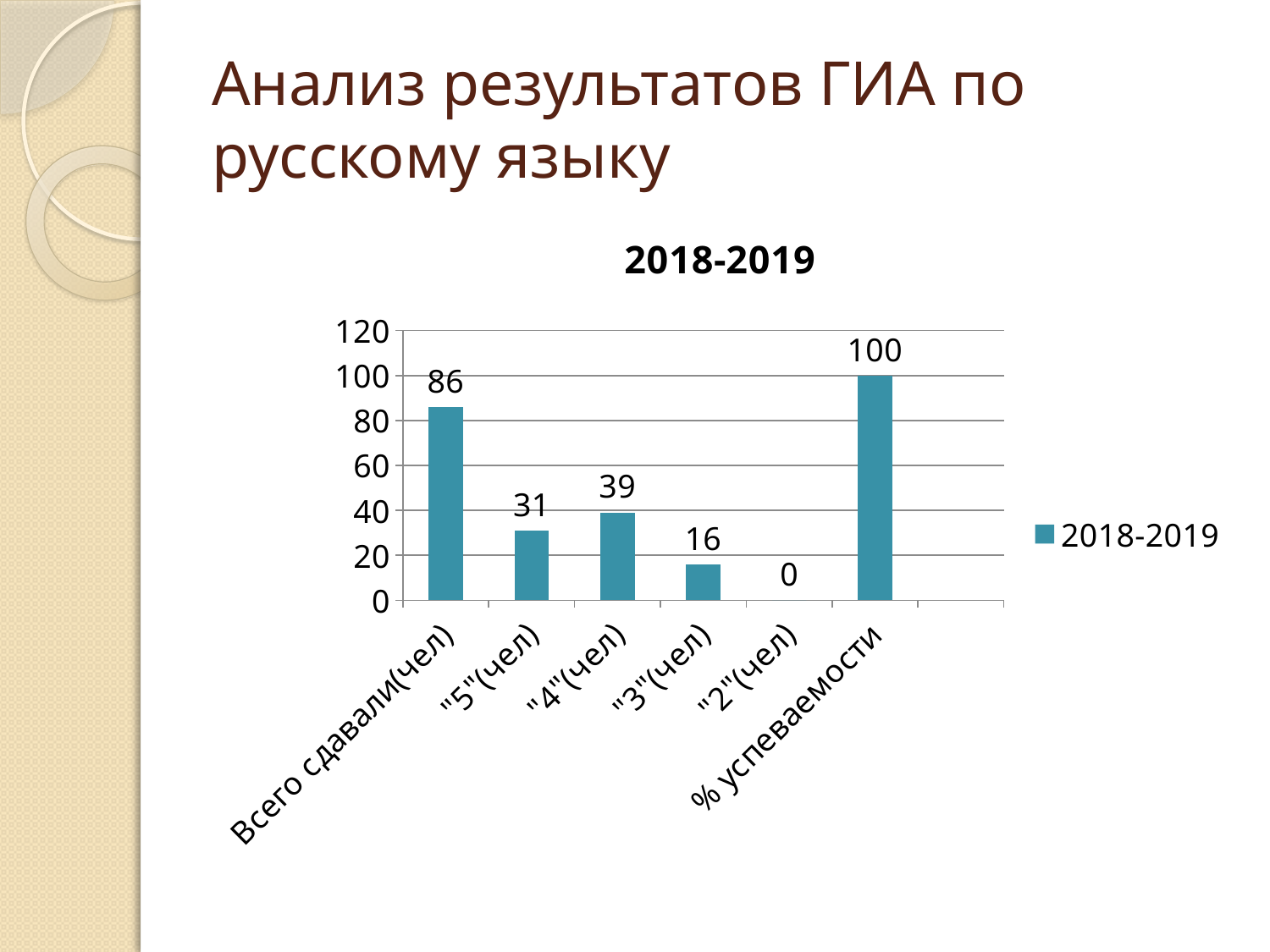
What is the value for "2"(чел)? 0 What is the value for "% успеваемости"? 100 Which category has the highest value? % успеваемости What is the value for "5"(чел)? 31 What is the value for "4"(чел)? 39 What is the value for "3"(чел)? 16 What kind of chart is shown on the slide? Bar chart What is the value for "Всего сдавали(чел)"? 86 Which category has the lowest value? "2"(чел) How many categories are shown on the x axis? 6 Which is larger, the value for "5"(чел) or the value for "3"(чел)? "5"(чел) What is the difference between the values for "4"(чел) and "5"(чел)? 8